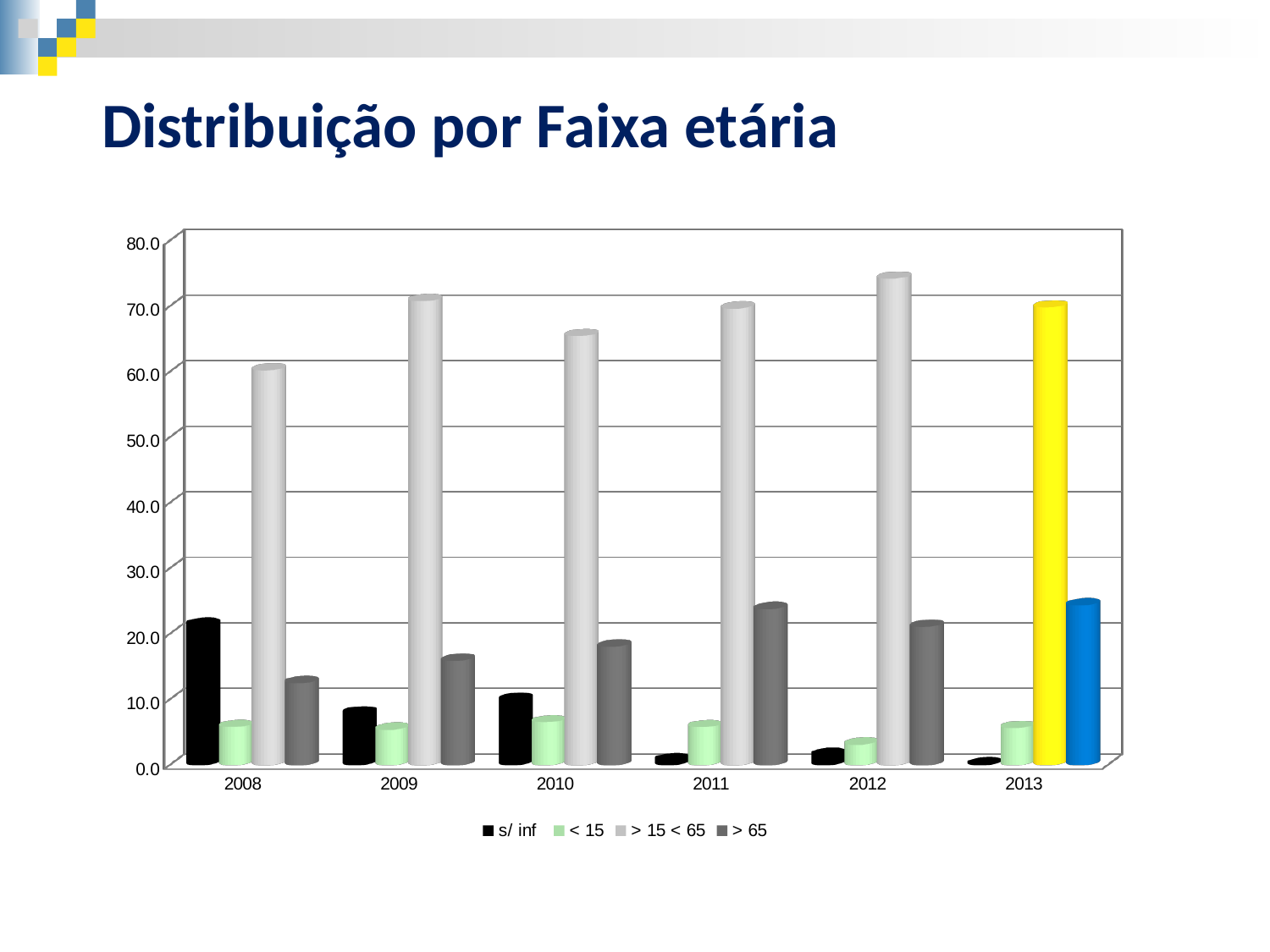
In which year is the 's/ inf' bar the tallest? 2008 What is the title of the chart? Distribuição por Faixa etária Does the 's/ inf' series rise or fall from 2008 to 2011? fall What kind of chart is shown on the slide? bar chart Is the value for '> 65' in 2009 greater or less than 20? less In 2008, which is larger: the 's/ inf' bar or the '> 65' bar? s/ inf How many series does the legend list? 4 Which series has the tallest bar in 2008? > 15 < 65 How many years are shown on the x axis? 6 Is the value for '> 15 < 65' in 2012 greater or less than 70? greater In which year is the '> 15 < 65' bar the tallest? 2012 Is the value for 's/ inf' in 2008 greater or less than 10? greater